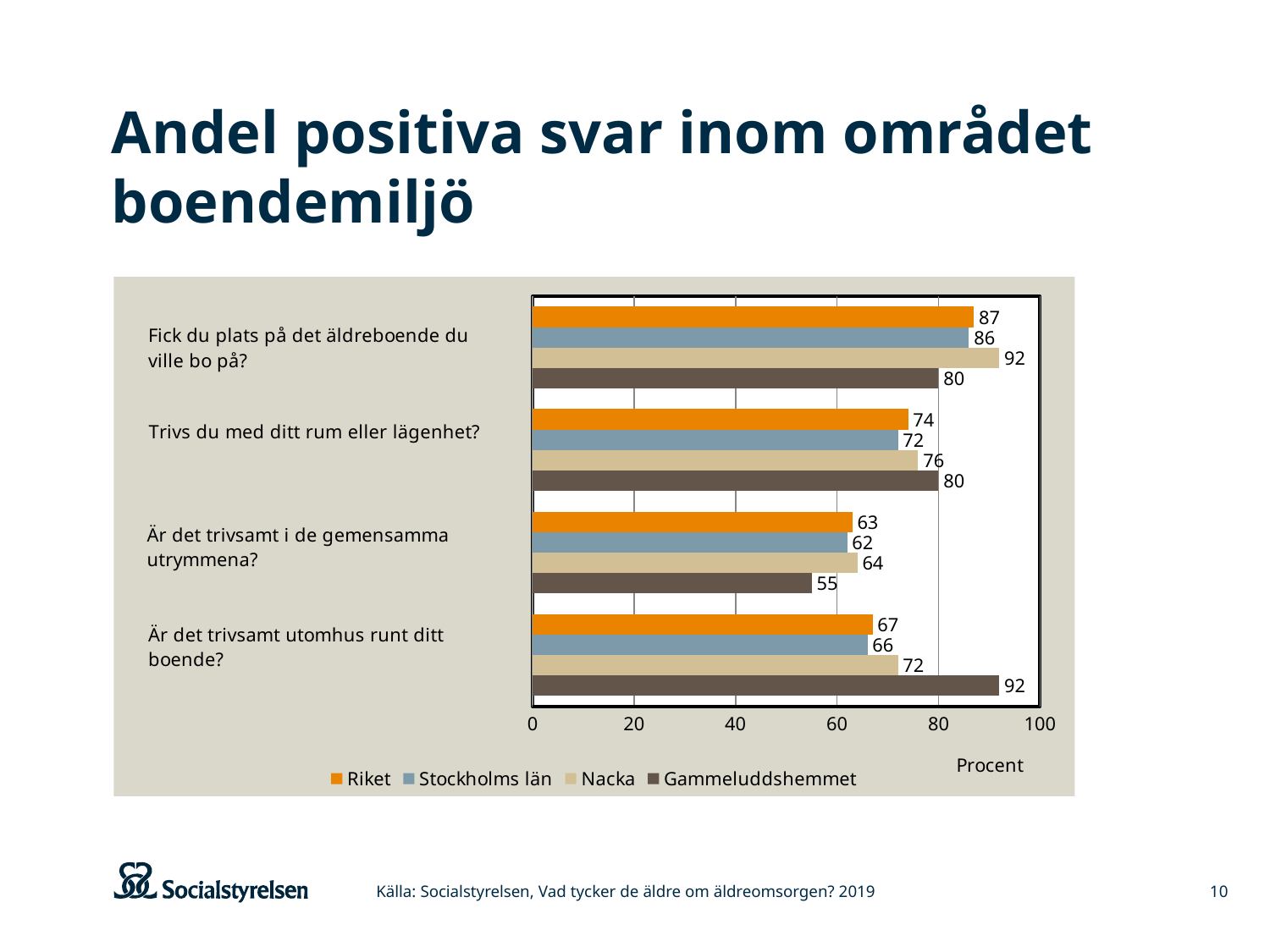
What kind of chart is shown on the slide? Bar chart Which series has the highest value on "Är det trivsamt utomhus runt ditt boende?"? Gammeluddshemmet What is the label on the horizontal axis of the chart? Procent Which is larger on "Fick du plats på det äldreboende du ville bo på?": Nacka or Gammeluddshemmet? Nacka What is the difference between Gammeluddshemmet and Riket on "Är det trivsamt utomhus runt ditt boende?"? 25 How many series does the legend list? 4 Which series has the lowest value on "Är det trivsamt i de gemensamma utrymmena?"? Gammeluddshemmet What is the value for Stockholms län on "Trivs du med ditt rum eller lägenhet?"? 72 What is the value for Gammeluddshemmet on "Är det trivsamt i de gemensamma utrymmena?"? 55 What is the value for Nacka on "Fick du plats på det äldreboende du ville bo på?"? 92 What is the value for Riket on "Är det trivsamt utomhus runt ditt boende?"? 67 How many question categories are shown on the chart? 4